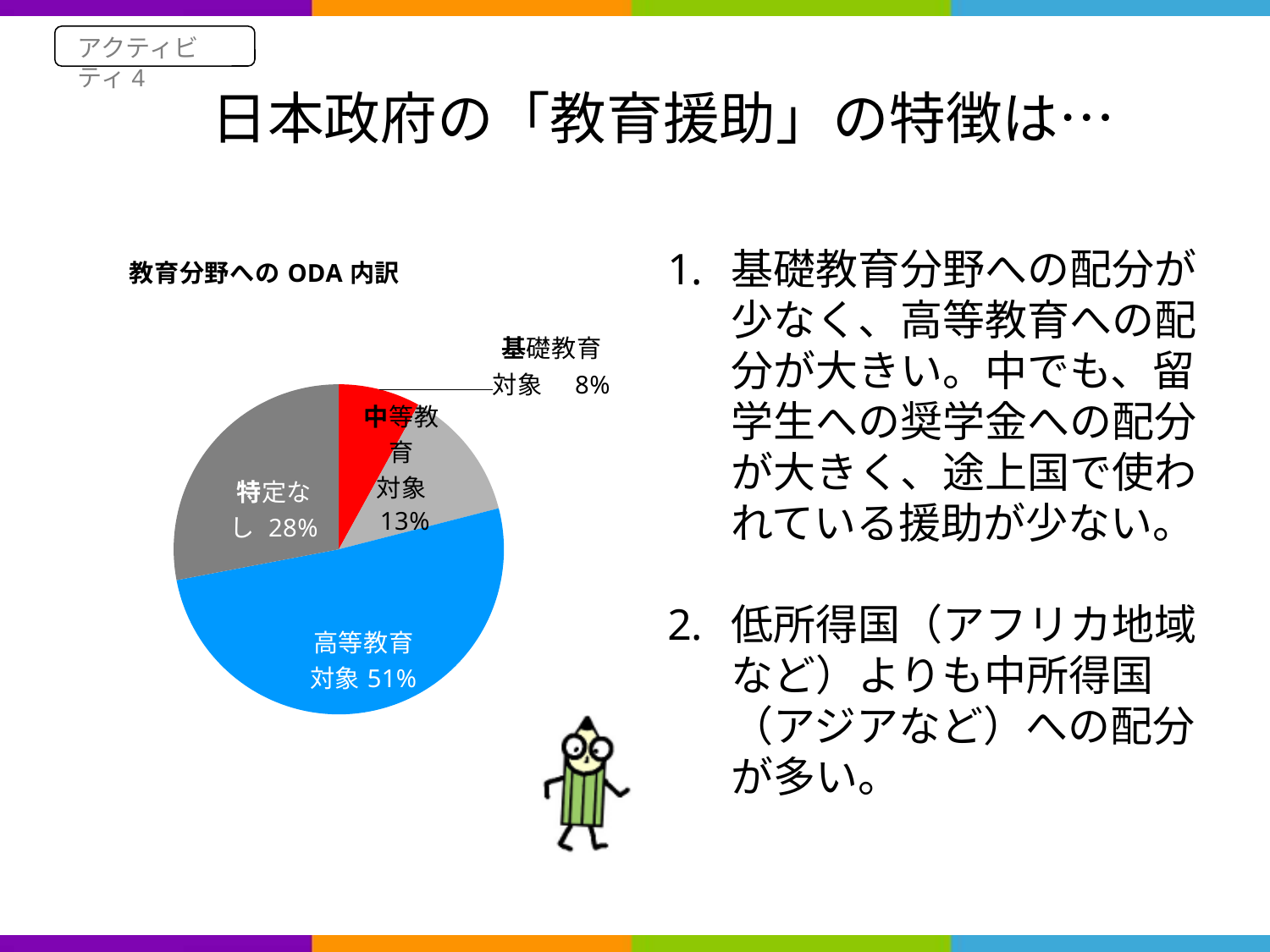
What share of the pie does 基礎教育対象 represent? 8% What is the difference in percentage points between 高等教育対象 and 特定なし? 23 How many slices does the pie chart have? 4 Which slice of the pie is the largest? 高等教育対象 Which is larger, the share for 中等教育対象 or the share for 基礎教育対象? 中等教育対象 What share of the pie does 高等教育対象 represent? 51% What share of the pie does 中等教育対象 represent? 13% Which slice of the pie is the smallest? 基礎教育対象 What kind of chart is shown on the slide? pie chart What is the title of the chart? 教育分野への ODA 内訳 What colour is the 高等教育対象 slice? blue What share of the pie does 特定なし represent? 28%